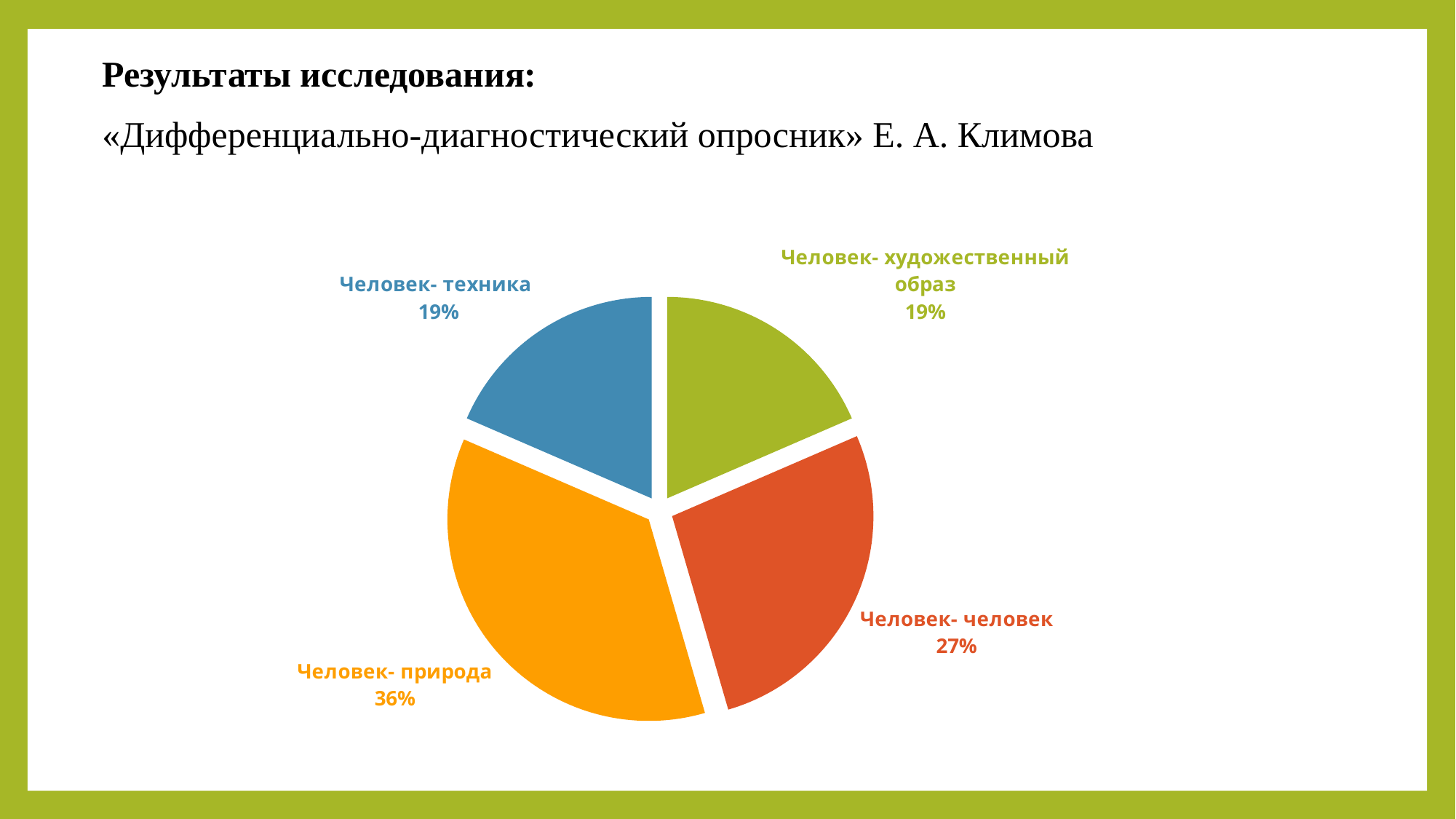
What is the difference between the shares of «Человек- природа» and «Человек- человек»? 9% What colour is the «Человек- техника» slice? blue What kind of chart is shown on the slide? pie chart Which is larger: the share of «Человек- человек» or the share of «Человек- техника»? Человек- человек What is the difference between the shares of «Человек- человек» and «Человек- техника»? 8% What colour is the «Человек- природа» slice? orange What share of the pie does «Человек- природа» have? 36% Which category has the largest slice of the pie? Человек- природа What share of the pie does «Человек- художественный образ» have? 19% What share of the pie does «Человек- человек» have? 27% How many slices does the pie chart have? 4